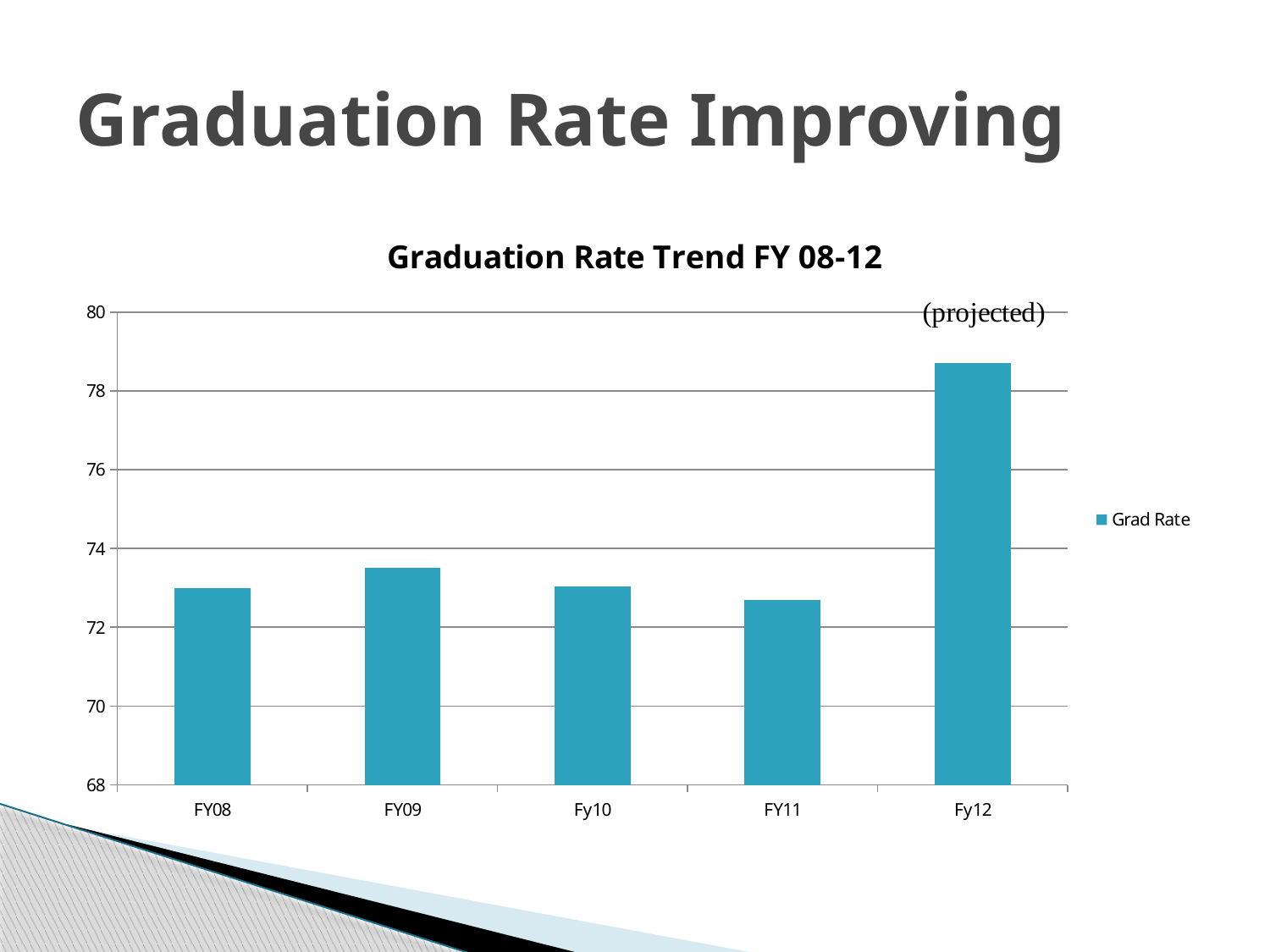
Which fiscal year has the highest graduation rate? Fy12 Is the value for FY11 greater or less than 72? greater Does the graduation rate rise or fall from FY11 to Fy12? rise Which is larger, the value for Fy12 or the value for Fy10? Fy12 What is the name of the series shown in the legend? Grad Rate What kind of chart is shown on the slide? bar chart What is the title of the chart? Graduation Rate Trend FY 08-12 Which is larger, the value for FY09 or the value for FY11? FY09 How many series does the legend list? 1 How many fiscal years are plotted on the x axis? 5 Is the value for Fy12 greater or less than 78? greater Is the value for FY08 greater or less than 74? less